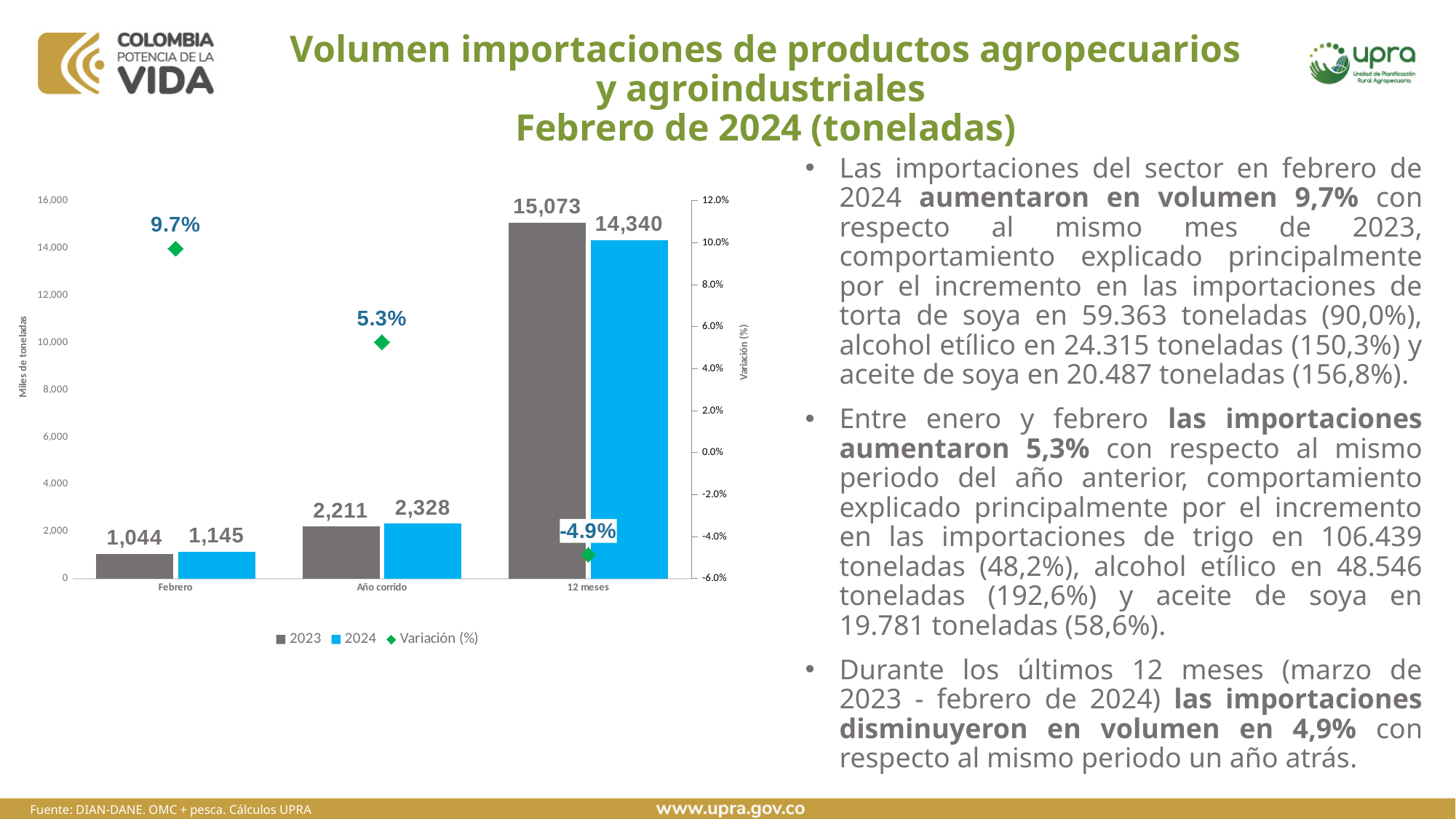
Which category has the lowest 2023 value? Febrero What is the difference between the 2023 and 2024 values for 12 meses? 733 What kind of chart is used for the 2023 and 2024 series? bar chart Which category has the highest 2024 value? 12 meses What is the label of the left vertical axis? Miles de toneladas What is the Variación (%) value for 12 meses? -4.9% How many categories are shown on the x axis? 3 How many series does the legend list? 3 Which is larger for Año corrido, the 2023 value or the 2024 value? 2024 What is the 2024 value for 12 meses? 14,340 What is the 2023 value for Febrero? 1,044 What is the Variación (%) value for Año corrido? 5.3%